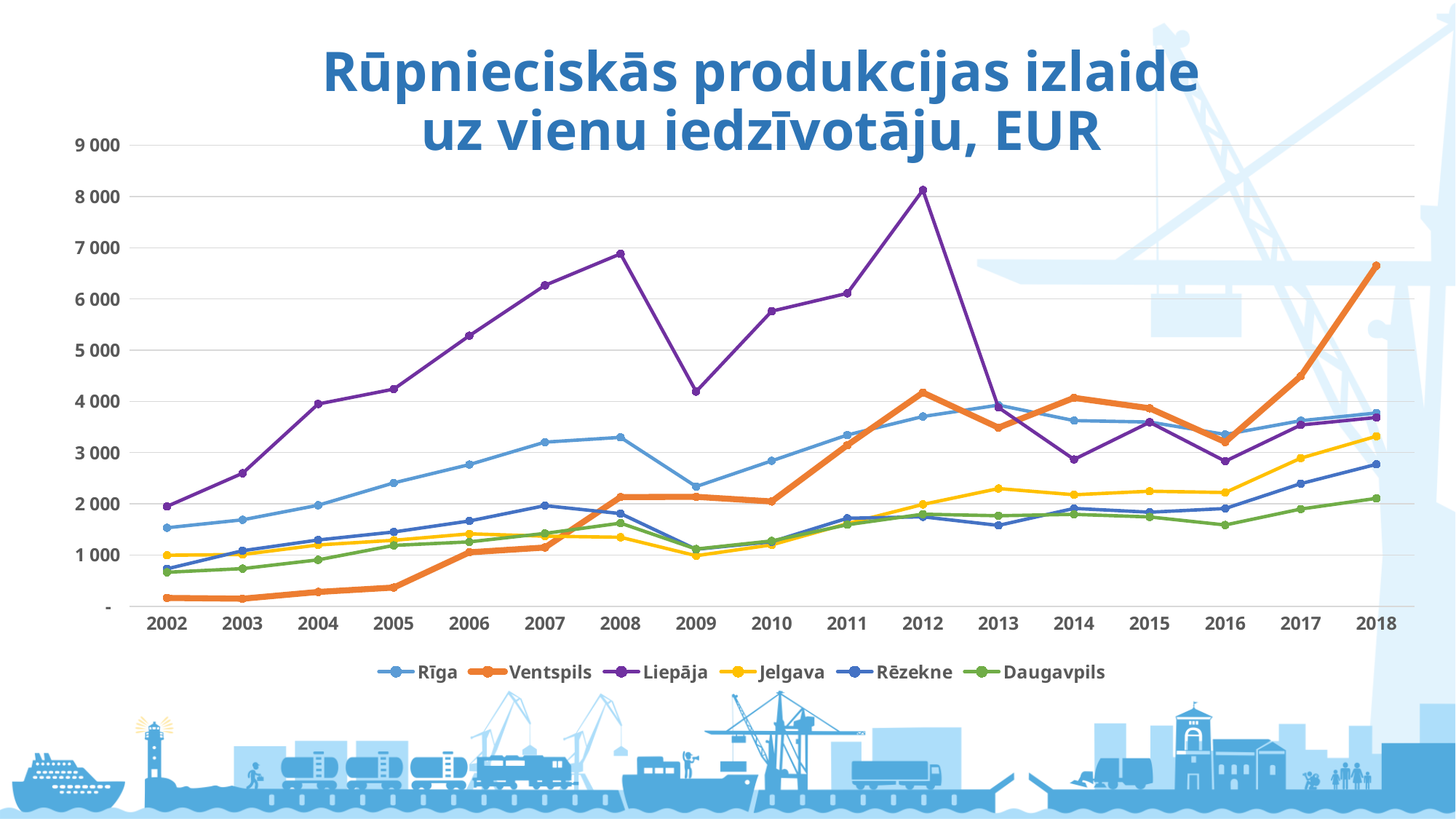
Is the value for Ventspils in 2018 greater or less than 6 000? greater Which city has the highest value in 2018? Ventspils Is the value for Liepāja in 2012 greater or less than 7 000? greater What kind of chart is shown on the slide? line chart Does the value for Ventspils rise or fall overall from 2002 to 2018? rise How many years are plotted along the x axis? 17 Which city has the lowest value in 2018? Daugavpils Is the value for Daugavpils in 2002 greater or less than 1 000? less How many series does the legend list? 6 Which city has the lowest value in 2002? Ventspils Which is larger: the value for Liepāja in 2008 or in 2009? 2008 Which city has the highest value in 2012? Liepāja